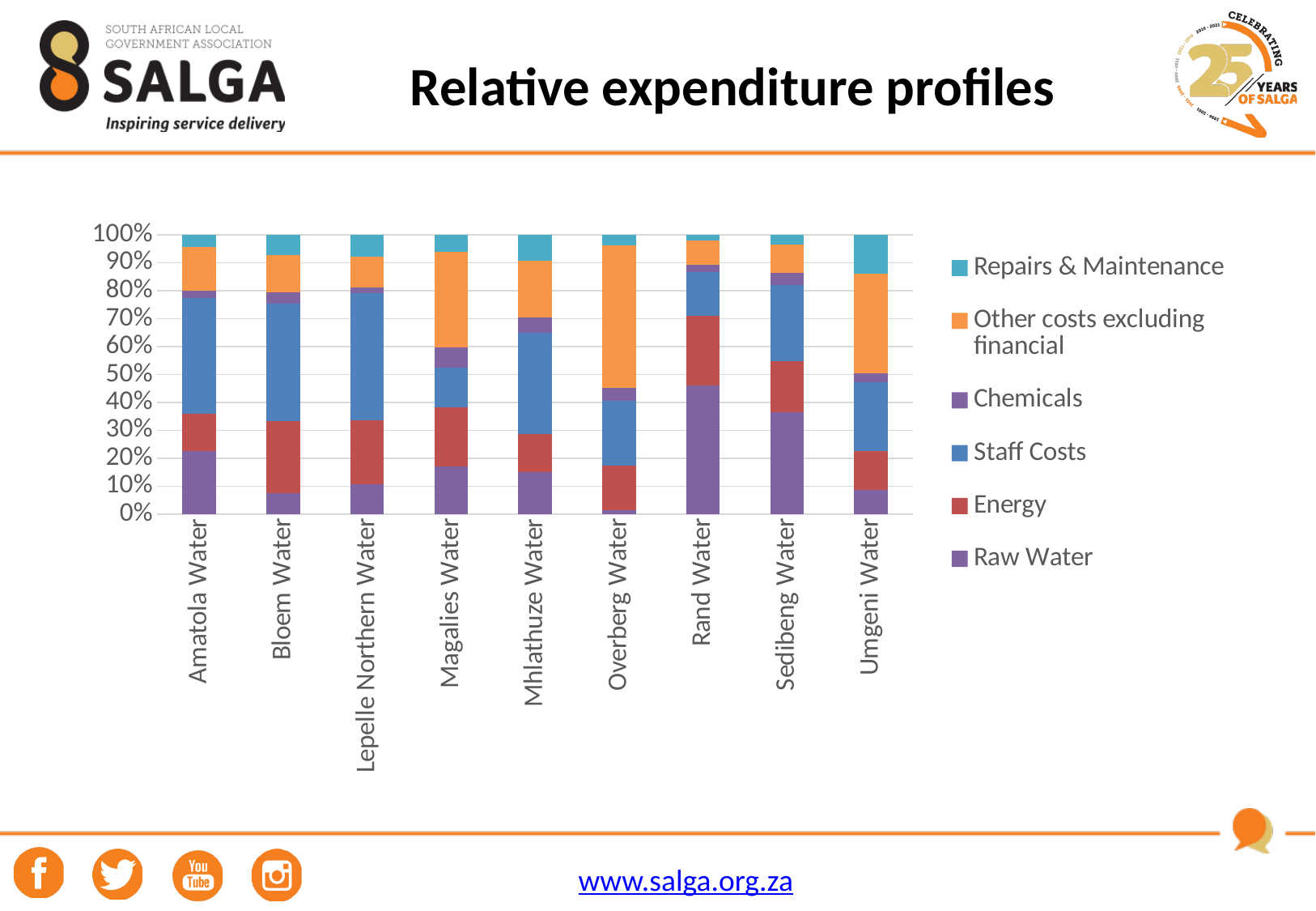
Which water board has the largest Raw Water share of expenditure? Rand Water What is the title of the slide containing the chart? Relative expenditure profiles Which colour represents Energy in the chart's legend? Red Which has the larger Staff Costs share, Lepelle Northern Water or Rand Water? Lepelle Northern Water Is the Raw Water share for Rand Water greater or less than 40%? greater How many water boards are shown along the x axis of the chart? 9 What kind of chart is shown on the slide? Stacked bar chart Which water board has the smallest Raw Water share of expenditure? Overberg Water Is the Raw Water share for Overberg Water greater or less than 10%? less Which water board has the largest Repairs & Maintenance share? Umgeni Water Which water board has the largest share for Other costs excluding financial? Overberg Water How many series does the chart's legend list? 6